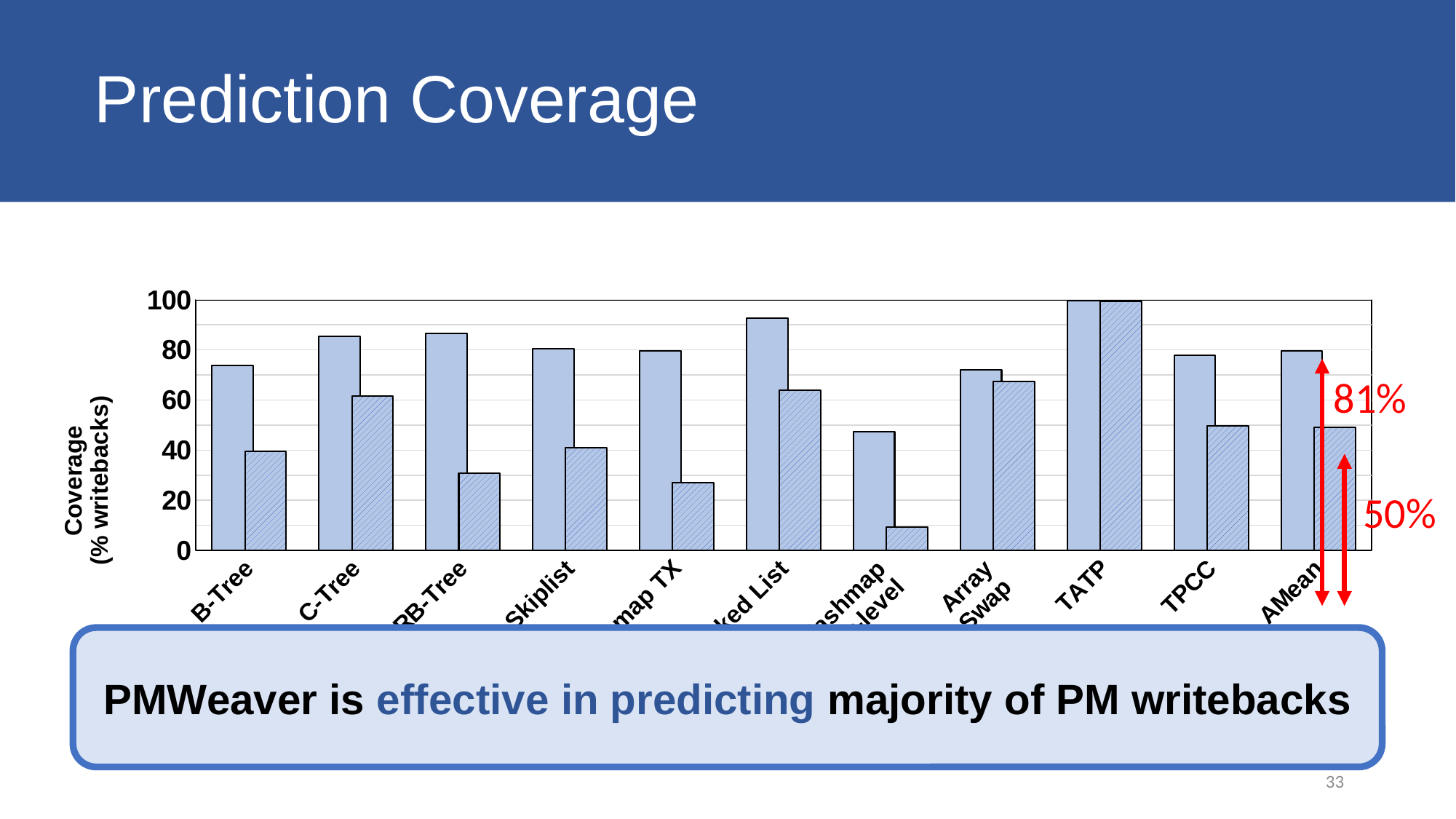
How many categories are shown along the x axis of the chart? 11 What value is annotated in red for the hatched (right) AMean bar? 50% What value is annotated in red for the solid (left) AMean bar? 81% Which is larger, the hatched (right) bar for Skiplist or the hatched (right) bar for RB-Tree? Skiplist Is the solid (left) bar for B-Tree greater or less than 60? greater Which category has the highest solid (left) bar? TATP What is the y-axis title of the chart? Coverage (% writebacks) Is the hatched (right) bar for B-Tree greater or less than 60? less Is the hatched (right) bar for Array Swap greater or less than 60? greater Which is larger, the solid (left) bar for C-Tree or the solid (left) bar for B-Tree? C-Tree What is the title of the slide containing the chart? Prediction Coverage What kind of chart is shown on the slide? bar chart